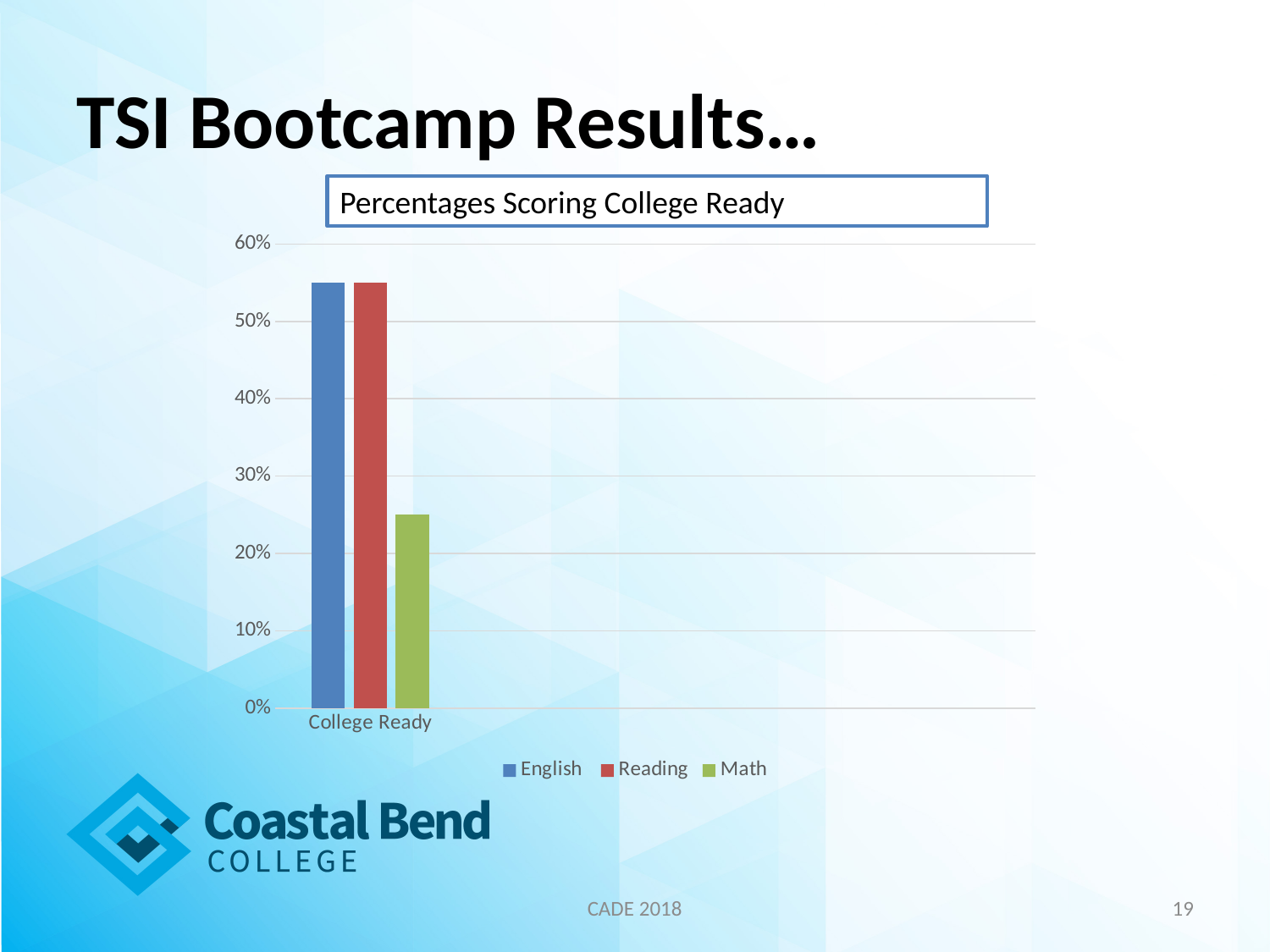
What kind of chart is shown on the slide? bar chart What is the title of the chart? Percentages Scoring College Ready Is the value for Math greater or less than 30%? less Is the value for Math greater or less than 20%? greater Which series has the lowest value for College Ready? Math Is the value for Reading greater or less than 50%? greater How many series does the legend list? 3 Which is larger, the value for Reading or the value for Math? Reading Which series is shown in green in the legend? Math Which is larger, the value for English or the value for Math? English How many categories are shown on the x axis? 1